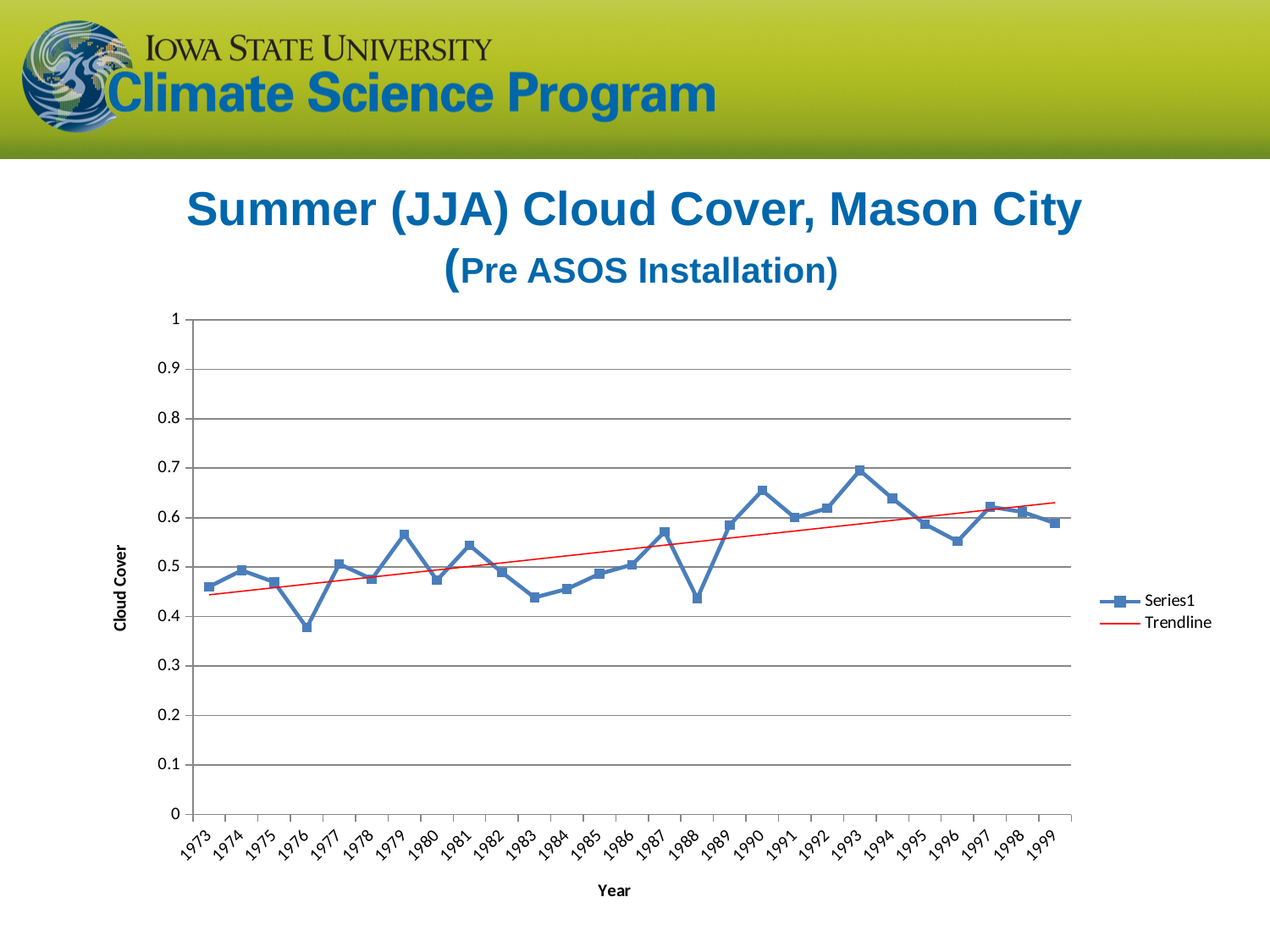
Is the cloud cover value for 1983 greater or less than 0.5? less Is the cloud cover value for 1993 greater or less than 0.6? greater Is the cloud cover value for 1976 greater or less than 0.4? less How many series does the legend list? 2 Which year has the larger cloud cover value, 1980 or 1990? 1990 Which year has the lowest summer cloud cover value? 1976 Which year has the highest summer cloud cover value? 1993 What is the label on the y axis of the chart? Cloud Cover How many years are plotted along the x axis? 27 What kind of chart is shown on the slide? line chart According to the trendline, does summer cloud cover rise or fall from 1973 to 1999? rise